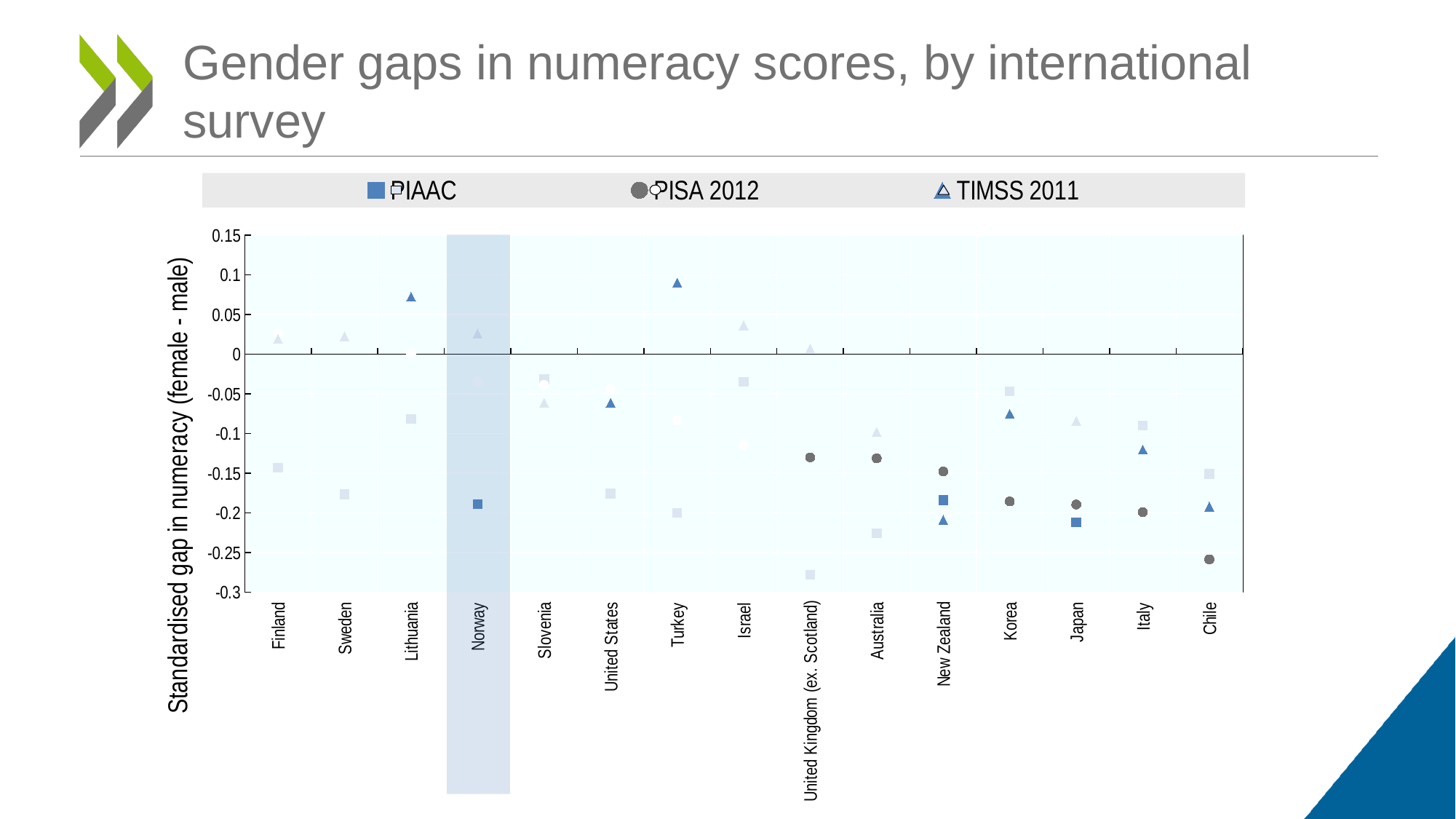
Is the TIMSS 2011 value for Turkey greater or less than 0.05? greater How many series does the legend list? 3 Which country has the lowest PIAAC value? United Kingdom (ex. Scotland) Which is larger, the PIAAC value for Finland or the PIAAC value for Sweden? Finland Is the PIAAC value for United Kingdom (ex. Scotland) greater or less than -0.25? less What kind of chart is shown on the slide? Scatter chart Which country is highlighted with a shaded column in the chart? Norway How many countries are shown on the x axis? 15 Which country has the highest TIMSS 2011 value? Turkey Which country has the lowest PISA 2012 value? Chile What is the title of the slide? Gender gaps in numeracy scores, by international survey Is the PIAAC value for Finland greater or less than -0.1? less